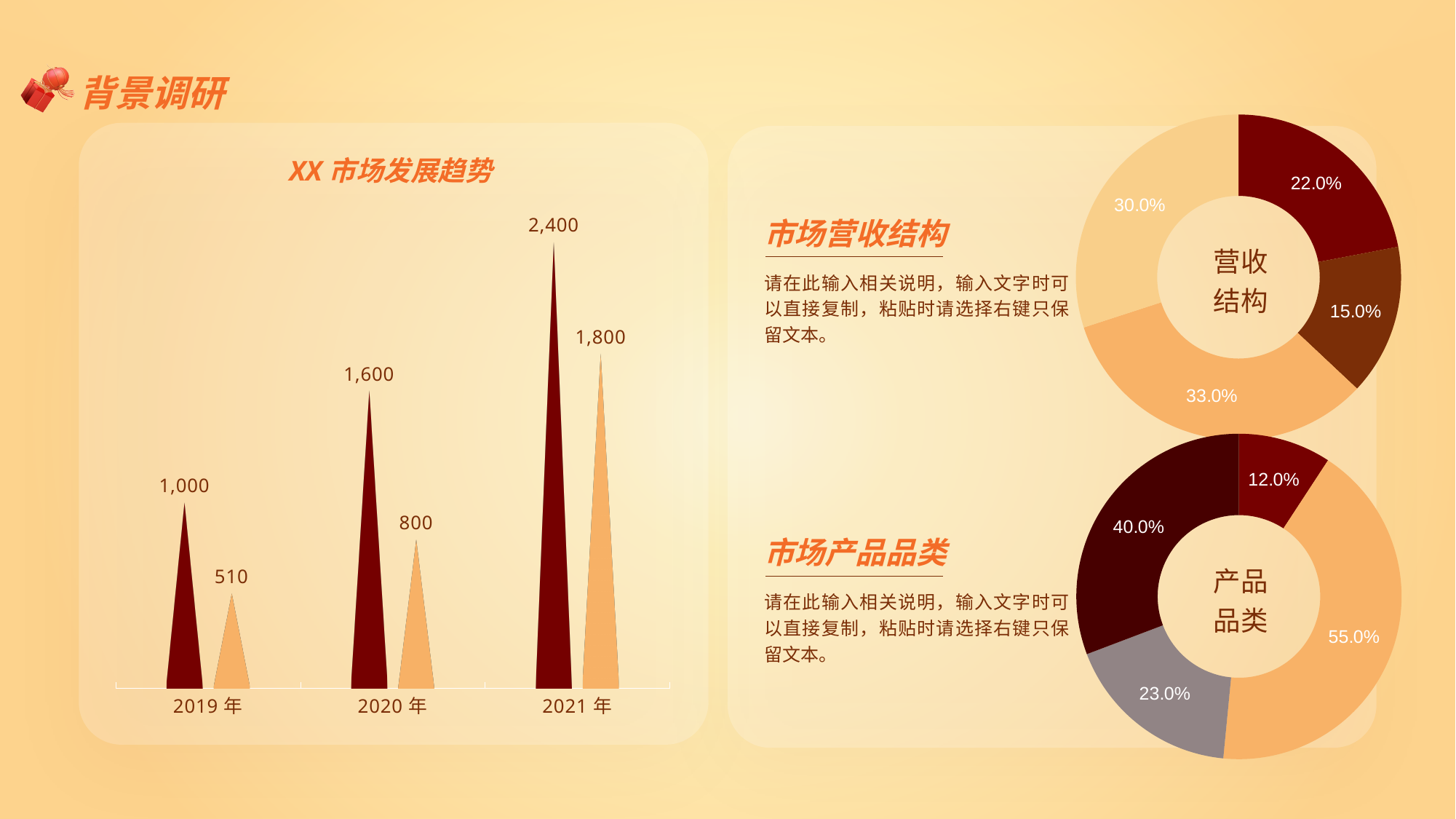
In the 营收结构 donut chart (top right), what is the share of the dark red slice? 22.0% In the chart titled XX 市场发展趋势, what is the value of the dark red bar for 2021 年? 2,400 In the 产品品类 donut chart (bottom right), which is larger, the dark red slice or the light orange slice? the light orange slice (55.0%) In the chart titled XX 市场发展趋势, what is the difference between the dark red and light orange bars for 2021 年? 600 In the 营收结构 donut chart (top right), which slice is the largest? 33.0% In the chart titled XX 市场发展趋势, which year has the highest dark red bar? 2021 年 In the chart titled XX 市场发展趋势, what is the value of the light orange bar for 2019 年? 510 In the chart titled XX 市场发展趋势, do the dark red bar values rise or fall from 2019 年 to 2021 年? rise In the chart titled XX 市场发展趋势, what is the value of the light orange bar for 2020 年? 800 What kind of chart is the chart titled XX 市场发展趋势? bar chart In the chart titled XX 市场发展趋势, how many years are shown on the x axis? 3 In the 产品品类 donut chart (bottom right), what is the share of the grey slice? 23.0%